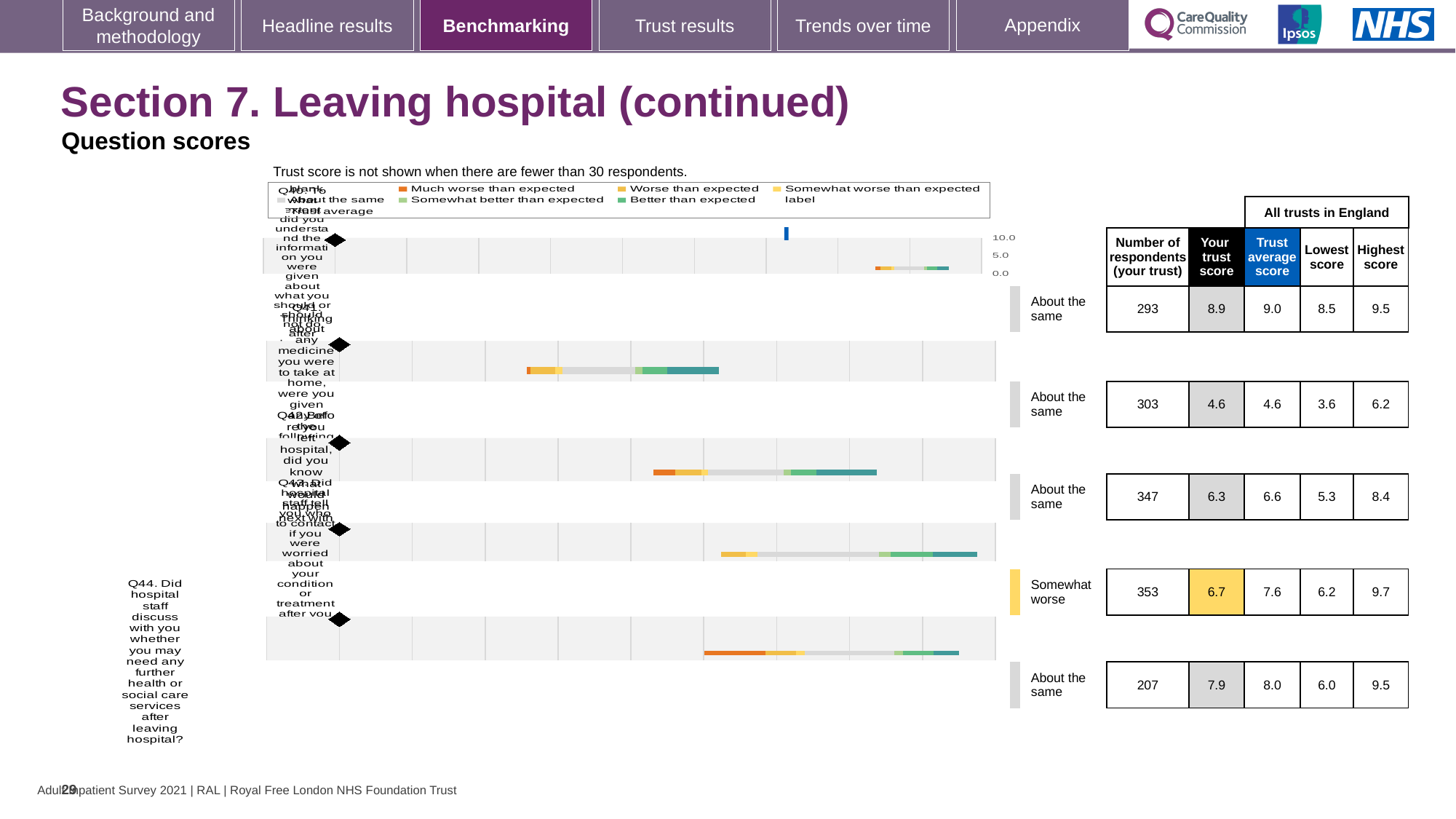
Is the 'Your trust score' for Q44 (the last row) larger or smaller than its trust average score? Smaller What is the difference between the trust average score and the 'Your trust score' for the row with 353 respondents? 0.9 What is the trust average score for the row with 353 respondents? 7.6 What is the 'Your trust score' for Q44 (the last row)? 7.9 Which row is rated 'Somewhat worse' rather than 'About the same'? The fourth row (353 respondents) Which row has the lowest 'Your trust score'? The second row (303 respondents), 4.6 What is the 'Your trust score' for the row with 353 respondents? 6.7 What kind of chart is used to show the benchmarking results on this slide? Bar chart How many questions (rows) are shown in the benchmarking chart on this slide? 5 What is the highest score across all trusts in England for the first row (293 respondents)? 9.5 How many respondents (your trust) are shown for Q44 (the last row)? 207 Which row has the highest 'Your trust score'? The first row (293 respondents), 8.9